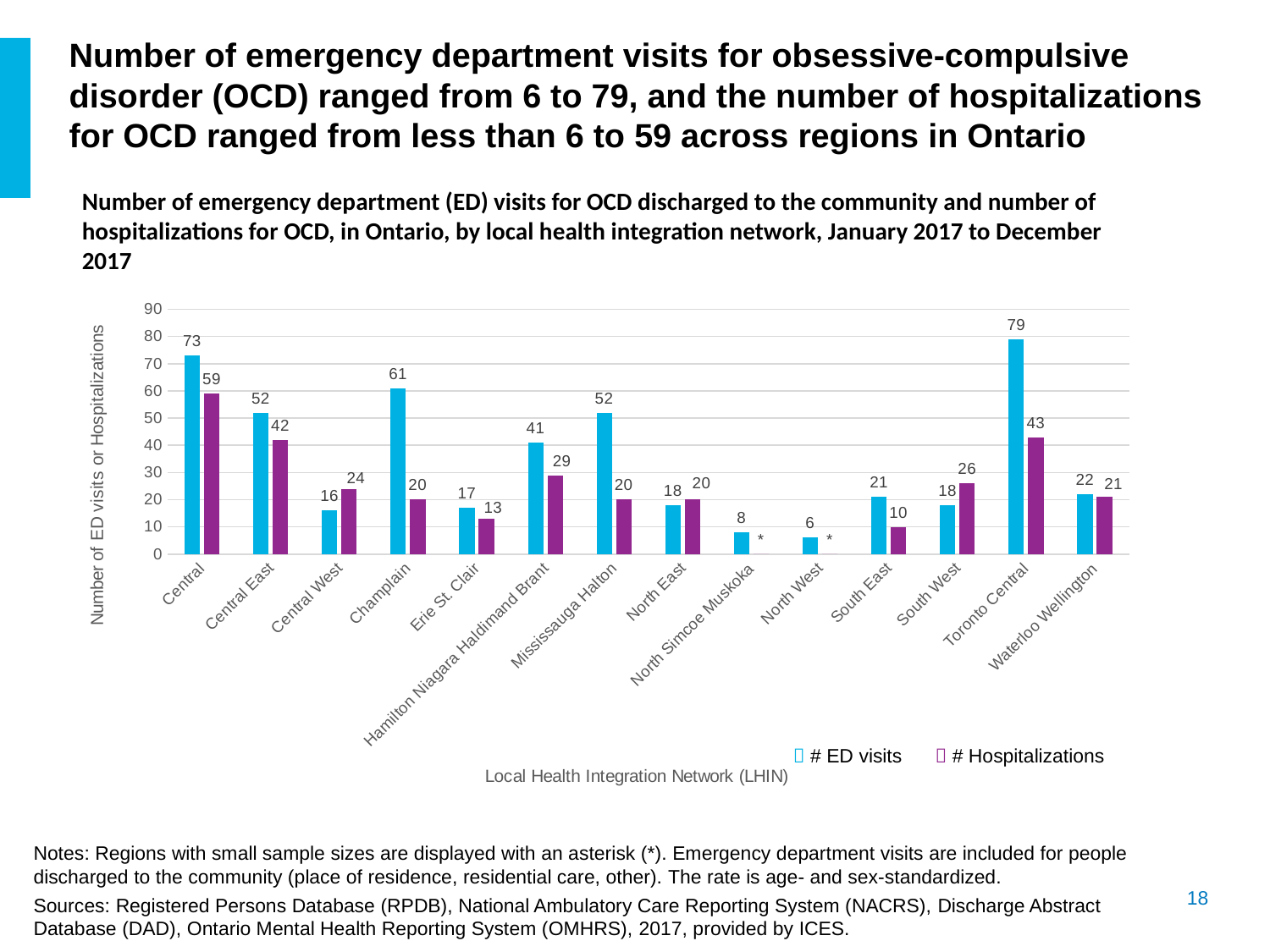
How many series does the legend list? 2 What is the number of hospitalizations for Hamilton Niagara Haldimand Brant? 29 What is the number of ED visits for the Central region? 73 Which region has the highest number of ED visits? Toronto Central For Central West, which is larger: the number of ED visits or the number of hospitalizations? # Hospitalizations What is the difference between the number of ED visits and the number of hospitalizations for the Central region? 14 What kind of chart is shown on the slide? Bar chart Which region has the highest number of hospitalizations? Central Which region has the lowest number of ED visits? North West What is displayed in place of the hospitalizations value for North Simcoe Muskoka? An asterisk (*) What is the number of hospitalizations for Toronto Central? 43 How many regions (LHINs) are shown on the x axis? 14